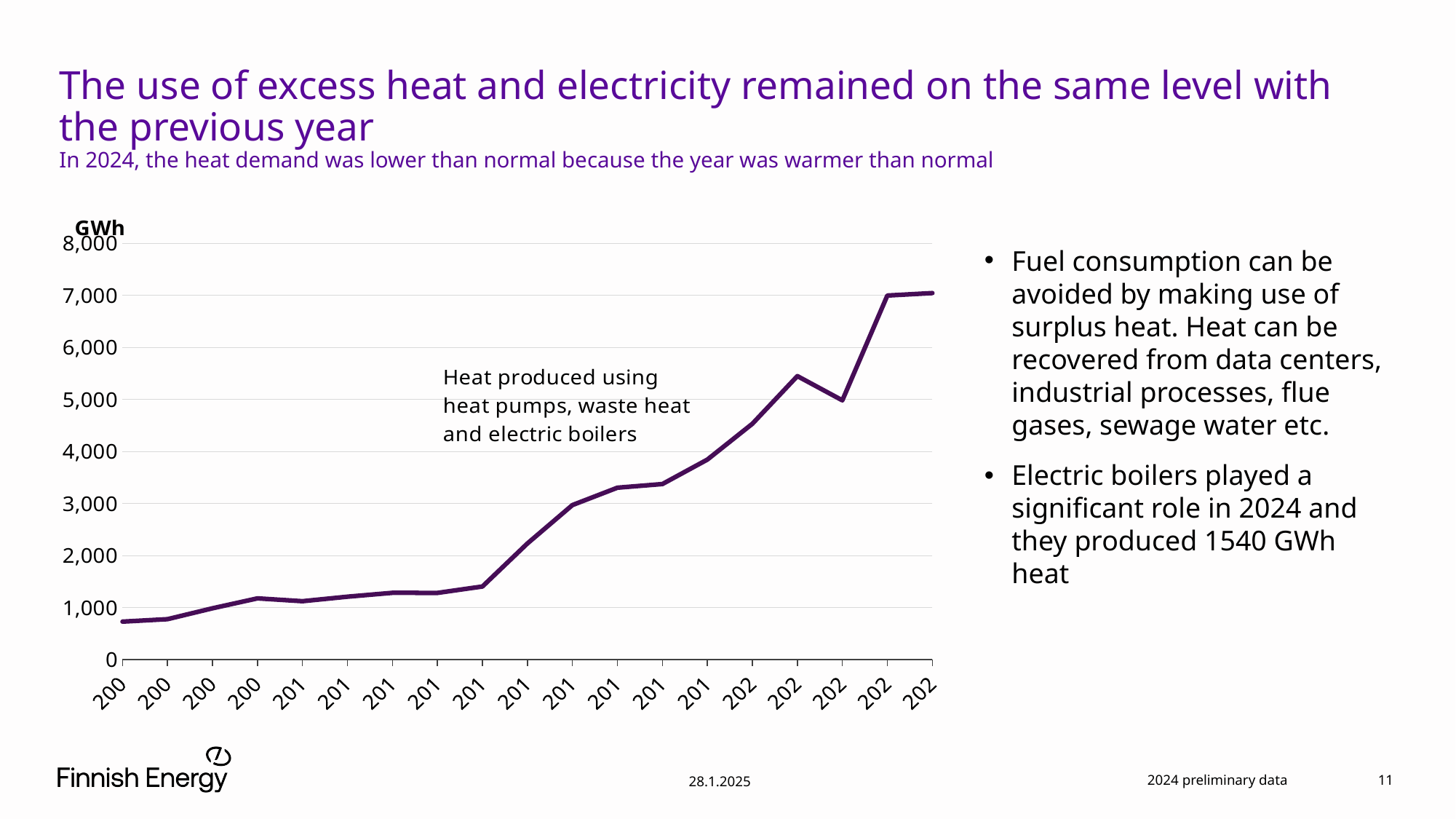
How many data points are plotted on the line chart? 19 What unit is shown on the y axis of the chart? GWh Is the value at the dip just before the final steep rise greater or less than 6,000? less Overall, do the values rise or fall from left to right along the x axis? rise Is the value at the rightmost point of the line greater or less than the value at the leftmost point? greater Is the value at the leftmost point of the line greater or less than 1,000? less Is the highest value on the line greater or less than 8,000? less What kind of chart is shown on the slide? line chart What does the line on the chart represent, according to the label on the chart? Heat produced using heat pumps, waste heat and electric boilers